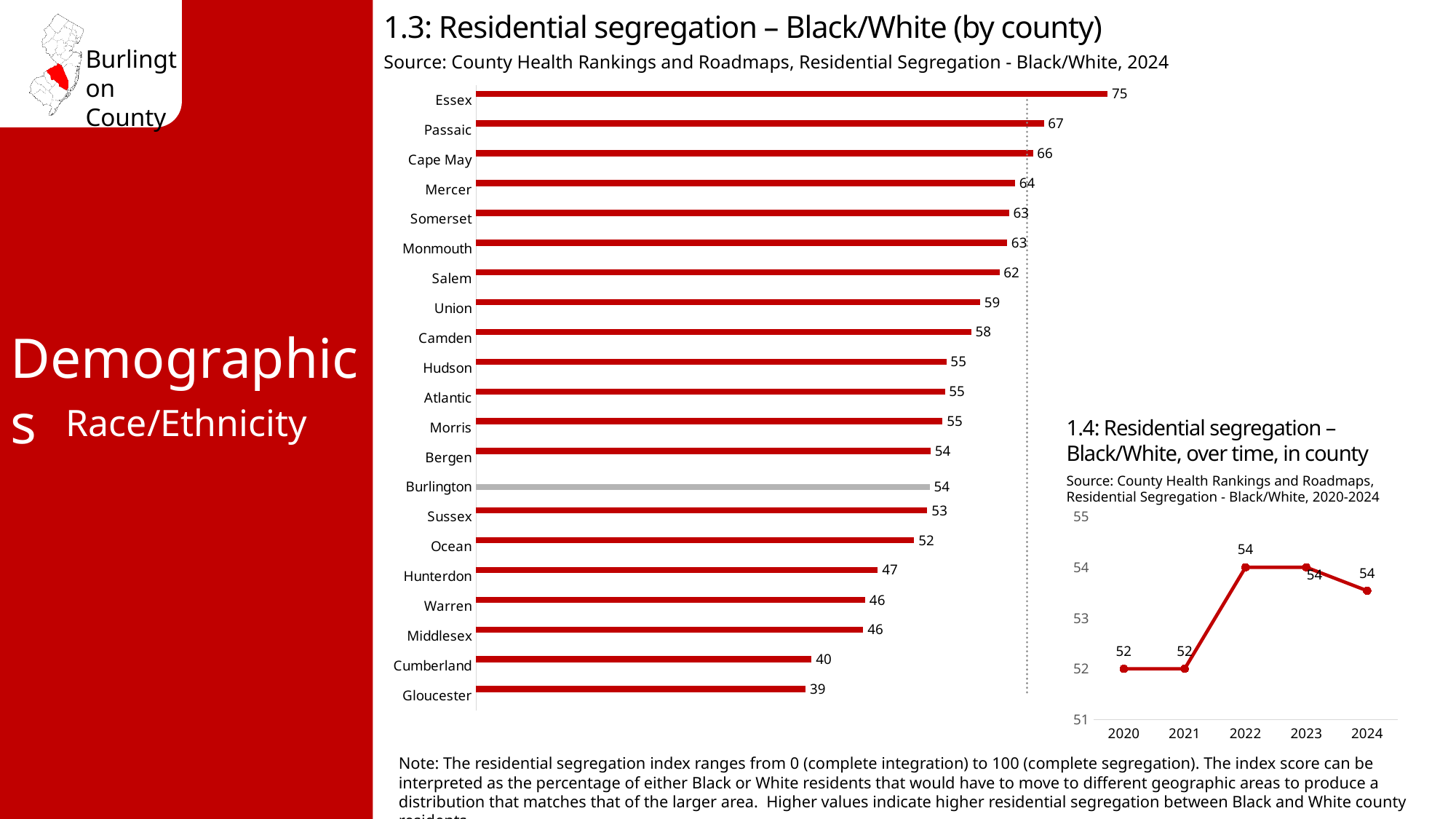
In chart 1.3 (by county), which county has the lowest value? Gloucester In chart 1.4 (Residential segregation – Black/White over time), what is the value for 2020? 52 In chart 1.3 (by county), which county has the highest value? Essex In chart 1.3 (by county), what is the value for Burlington? 54 In chart 1.3 (by county), which has a larger value, Passaic or Camden? Passaic In chart 1.3 (by county), what is the difference between the values for Essex and Gloucester? 36 In chart 1.3 (by county), how many counties are shown? 21 In chart 1.4 (over time), how many years are plotted? 5 In chart 1.4 (over time), what is the value for 2022? 54 What kind of chart is chart 1.3 (Residential segregation – Black/White by county)? Bar chart In chart 1.3 (Residential segregation – Black/White by county), what is the value for Essex? 75 In chart 1.3 (by county), what is the value for Cumberland? 40